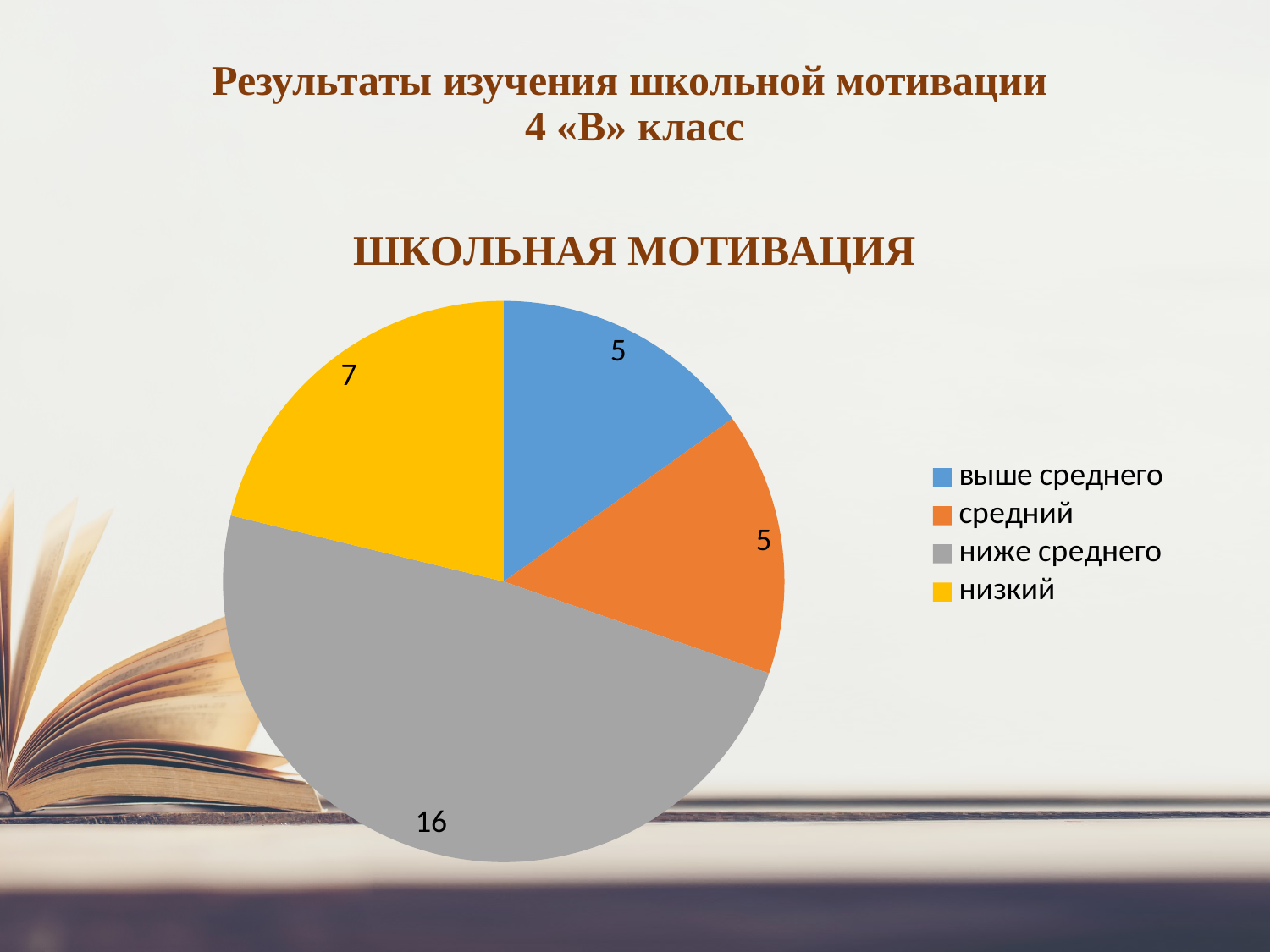
What is the value for the "выше среднего" slice? 5 Which colour represents "низкий" in the legend? Yellow What is the total of all the slices in the pie chart? 33 What is the title of the chart? ШКОЛЬНАЯ МОТИВАЦИЯ Which category has the largest slice of the pie? ниже среднего How many categories does the pie chart show? 4 What is the value for the "ниже среднего" slice? 16 What is the value for the "низкий" slice? 7 What is the value for the "средний" slice? 5 What is the difference between the values for "ниже среднего" and "низкий"? 9 Which is larger, the value for "низкий" or the value for "средний"? низкий What type of chart is shown on the slide? Pie chart